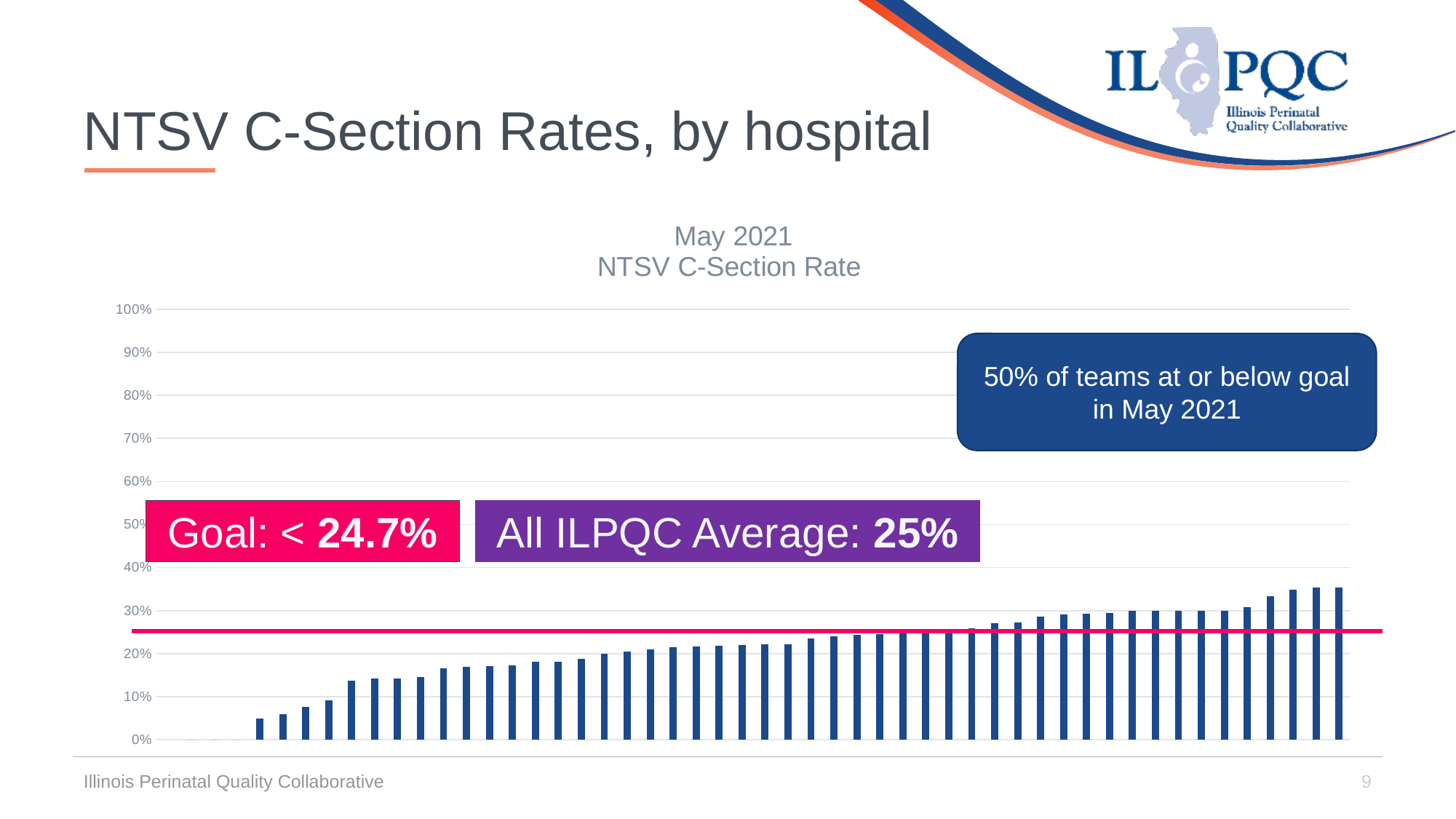
Is the value of the leftmost visible bar greater or less than 10%? less Is the value of the rightmost bar greater or less than 20%? greater What is the highest value shown on the y axis? 100% What is the title of the chart? May 2021 NTSV C-Section Rate What kind of chart is shown on the slide? bar chart What goal value for the NTSV C-Section rate is stated on the slide? < 24.7% Is the value of the tallest bar greater or less than 30%? greater Do the bar values rise or fall from left to right along the x axis? rise